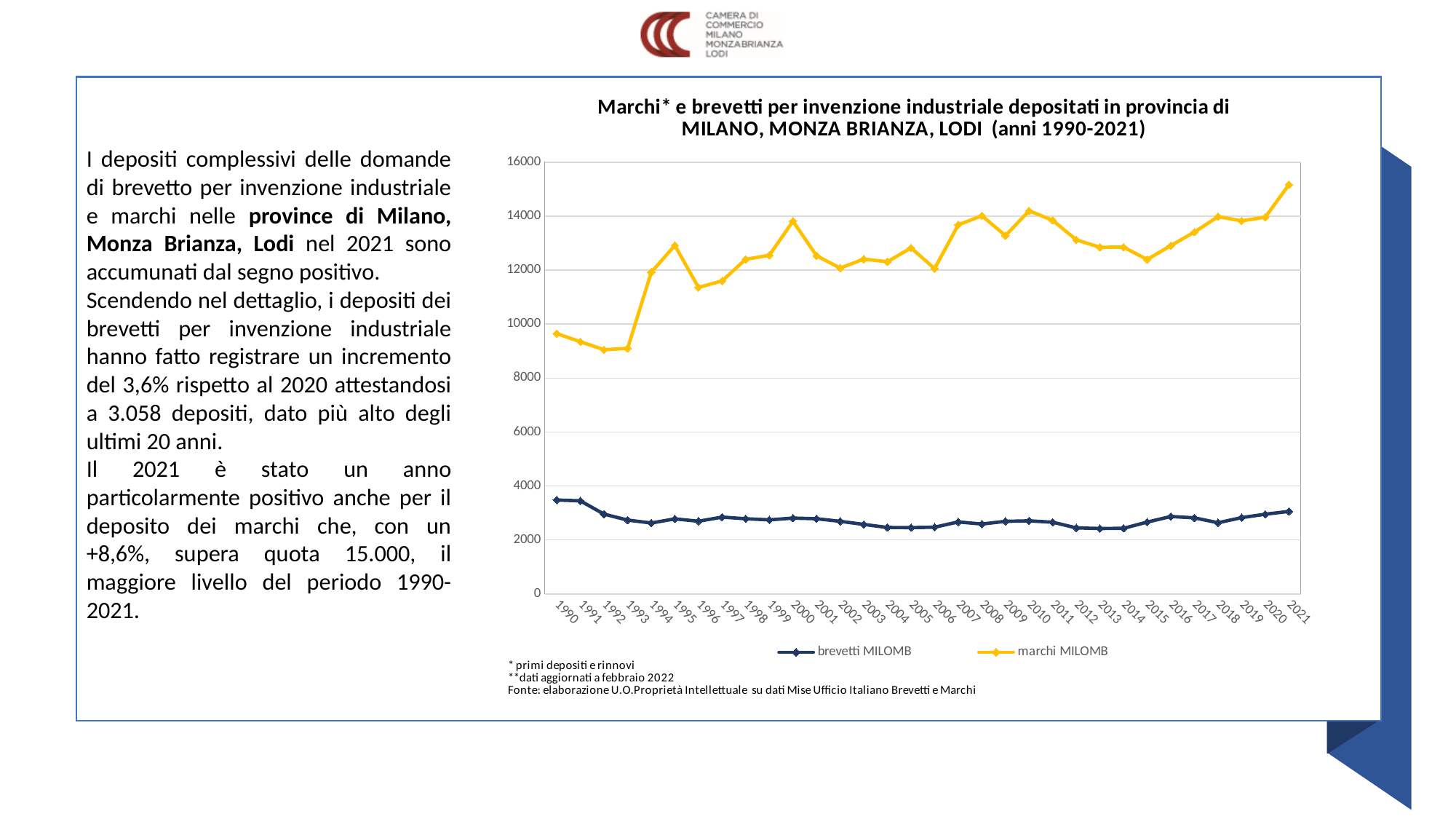
Is the value for brevetti MILOMB in 2021 greater or less than 4000? less What colour is the line for the marchi MILOMB series? yellow How many years are plotted along the x axis of the chart? 32 How many series does the chart legend list? 2 Does the marchi MILOMB series overall rise or fall from 1990 to 2021? rise What are the two series named in the chart legend? brevetti MILOMB and marchi MILOMB In which year does the marchi MILOMB series reach its highest value? 2021 Which series has the larger value in 2021, brevetti MILOMB or marchi MILOMB? marchi MILOMB Is the value for marchi MILOMB in 2000 greater or less than 12000? greater Is the value for marchi MILOMB in 2021 greater or less than 14000? greater What kind of chart is shown on the slide? line chart